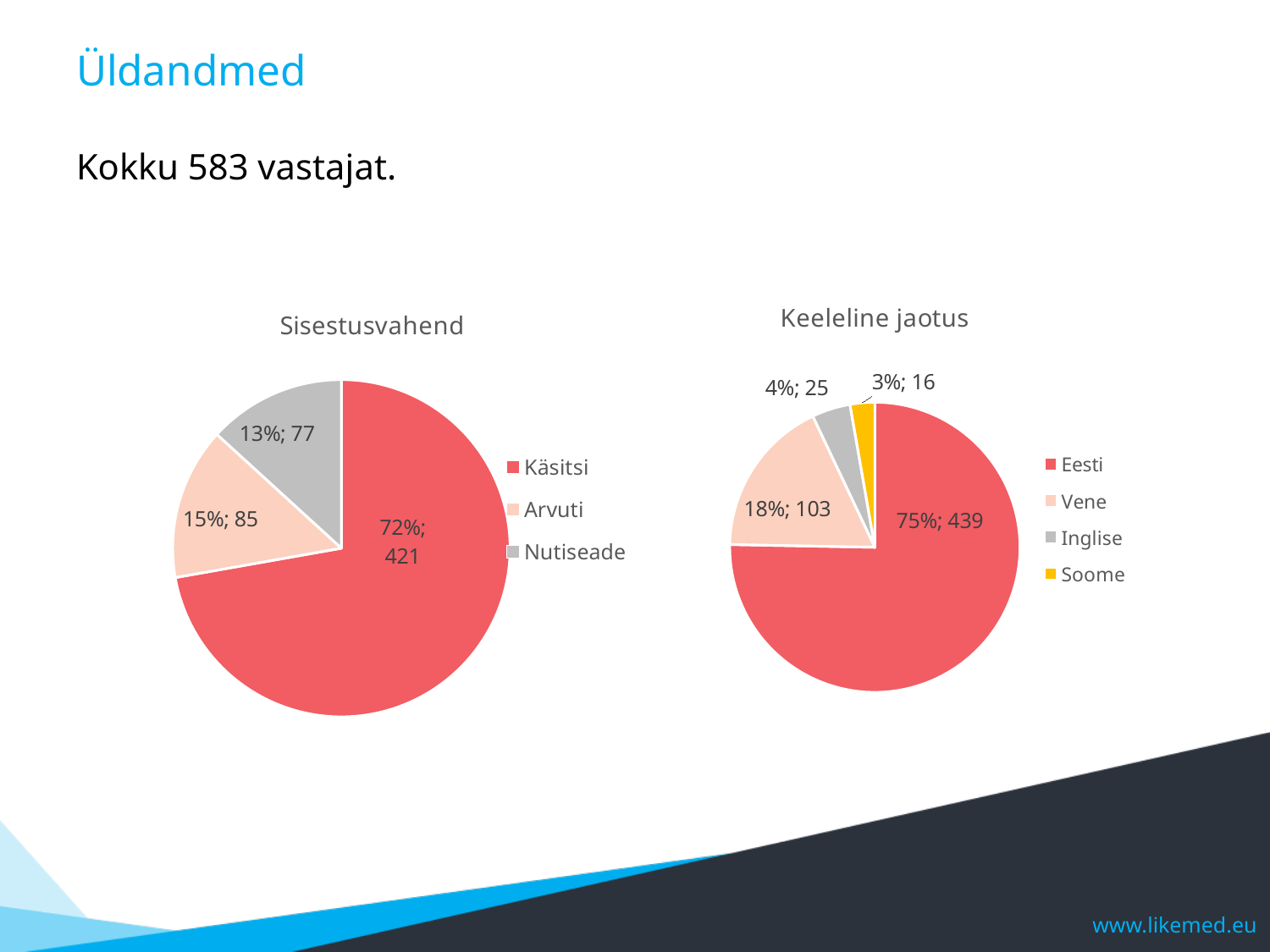
In the 'Keeleline jaotus' chart, how many categories does the legend list? 4 In the 'Sisestusvahend' chart, what is the count for Käsitsi? 421 In the 'Sisestusvahend' chart, which category has the smallest slice? Nutiseade In the 'Sisestusvahend' chart, what is the difference between the counts for Arvuti and Nutiseade? 8 In the 'Keeleline jaotus' chart, what percentage share does Eesti have? 75% In the 'Keeleline jaotus' chart, what is the difference between the counts for Eesti and Vene? 336 In the 'Sisestusvahend' chart, what percentage share does Arvuti have? 15% In the 'Keeleline jaotus' chart, what is the count for Vene? 103 In the 'Keeleline jaotus' chart, which is larger, the count for Inglise or the count for Soome? Inglise In the 'Sisestusvahend' chart, how many categories does the legend list? 3 In the 'Keeleline jaotus' chart, which category has the largest slice? Eesti In the 'Sisestusvahend' chart, what kind of chart is shown? pie chart